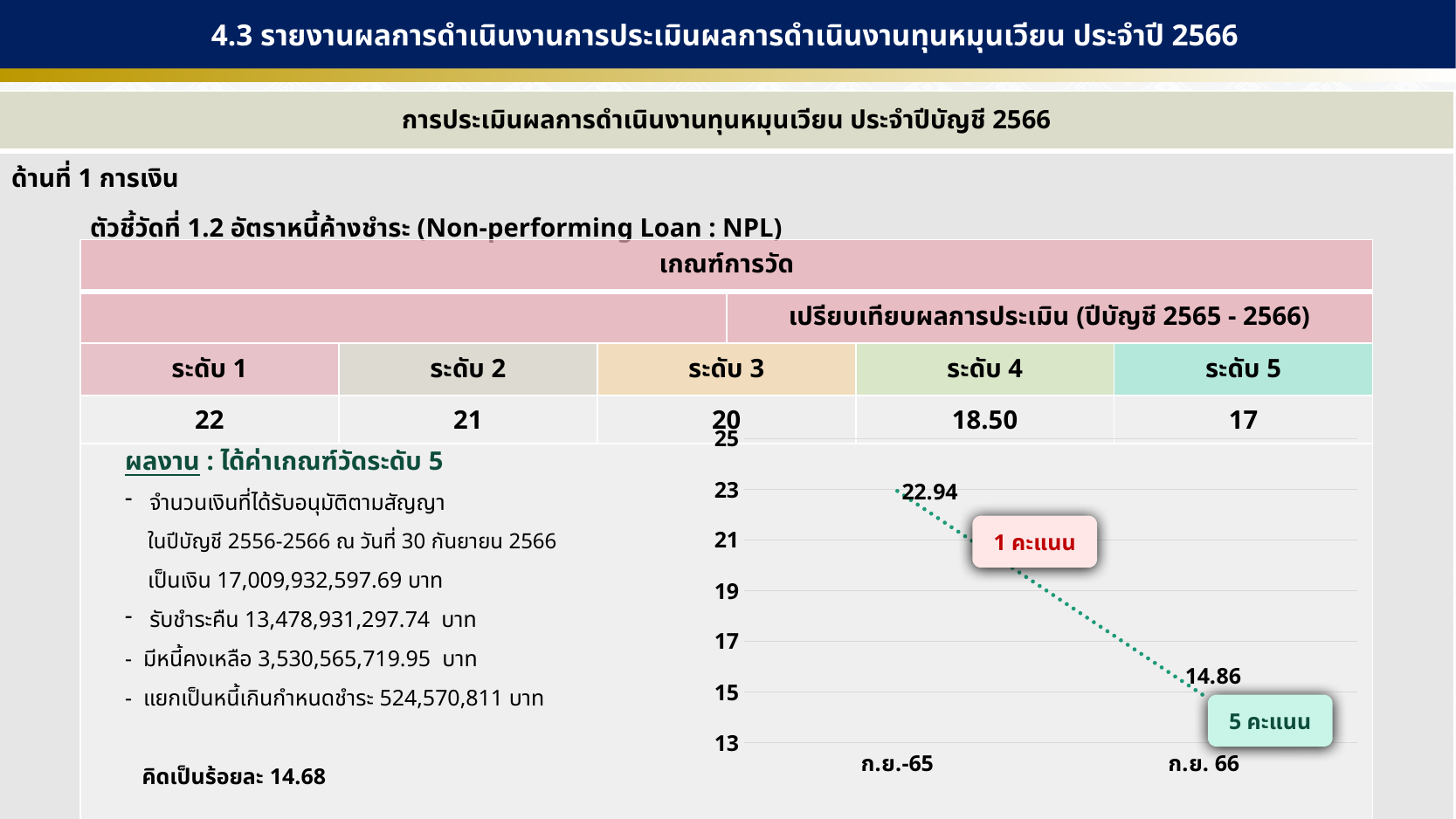
Is the value for ก.ย. 66 greater or less than 15? less How many data points are plotted on the chart? 2 Which category has the lowest value on the chart? ก.ย. 66 Is the value for ก.ย.-65 greater or less than 21? greater What is the value plotted for ก.ย. 66? 14.86 Which point on the chart has the higher value, ก.ย.-65 or ก.ย. 66? ก.ย.-65 Which category has the highest value on the chart? ก.ย.-65 What kind of chart is shown on the slide? line chart What is the value plotted for ก.ย.-65? 22.94 What is the difference between the values for ก.ย.-65 and ก.ย. 66? 8.08 Do the values rise or fall from ก.ย.-65 to ก.ย. 66? fall What score label is shown in the callout next to the ก.ย. 66 point? 5 คะแนน